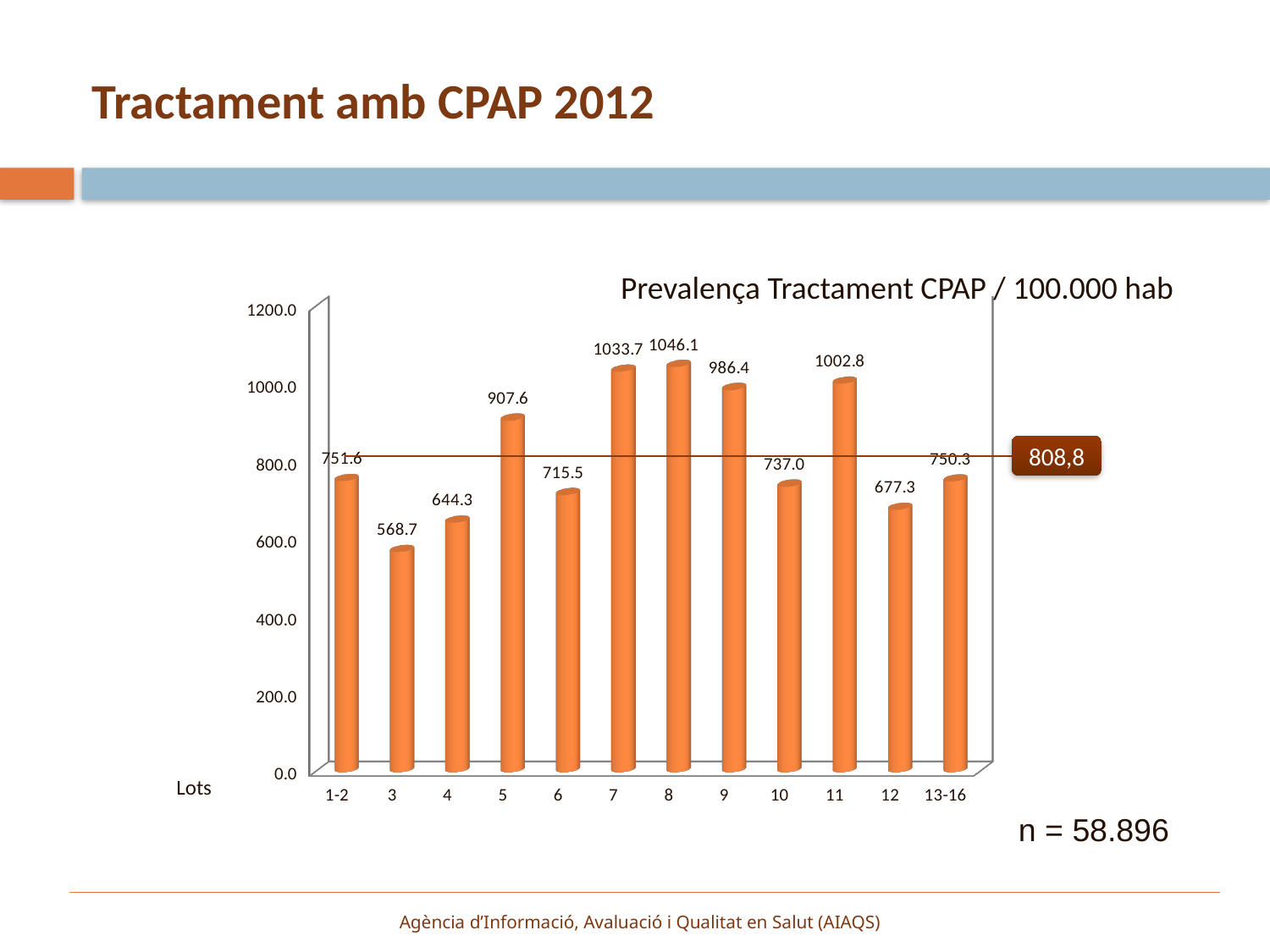
Which lot has the highest value? 8 Is the value for lot 10 greater or less than 800? less What kind of chart is shown on the slide? bar chart What is the value for lot 11? 1002.8 Which lot has the lowest value? 3 What value is shown in the label on the horizontal reference line? 808,8 What is the difference between the values for lot 7 and lot 6? 318.2 How many lot categories are shown on the x axis? 12 What is the difference between the values for lot 8 and lot 3? 477.4 Which is larger, the value for lot 9 or the value for lot 5? lot 9 What is the value for lot 5? 907.6 What is the value for lot 13-16? 750.3